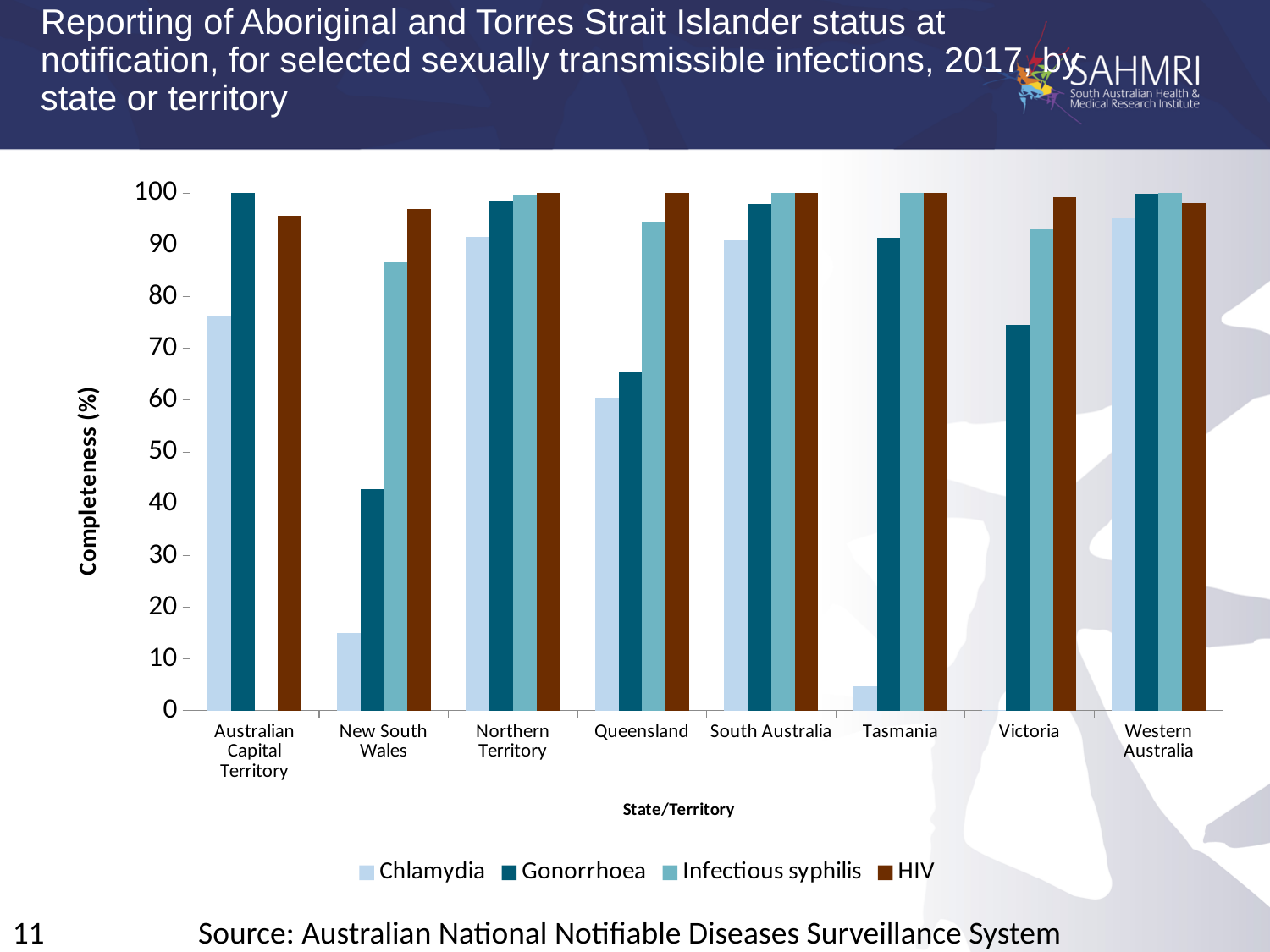
Which is larger: the Chlamydia value for Australian Capital Territory or for Queensland? Australian Capital Territory How many states or territories are shown on the x axis? 8 What kind of chart is shown on the slide? bar chart Is the Chlamydia value for New South Wales greater or less than 20? less Is the Gonorrhoea value for Victoria greater or less than 80? less Which is larger: the Gonorrhoea value for New South Wales or for Victoria? Victoria What is the title of the y axis? Completeness (%) Is the Chlamydia value for Tasmania greater or less than 10? less How many series does the legend list? 4 Which state or territory has the lowest Gonorrhoea completeness? New South Wales Which state or territory has the lowest Chlamydia completeness? Victoria